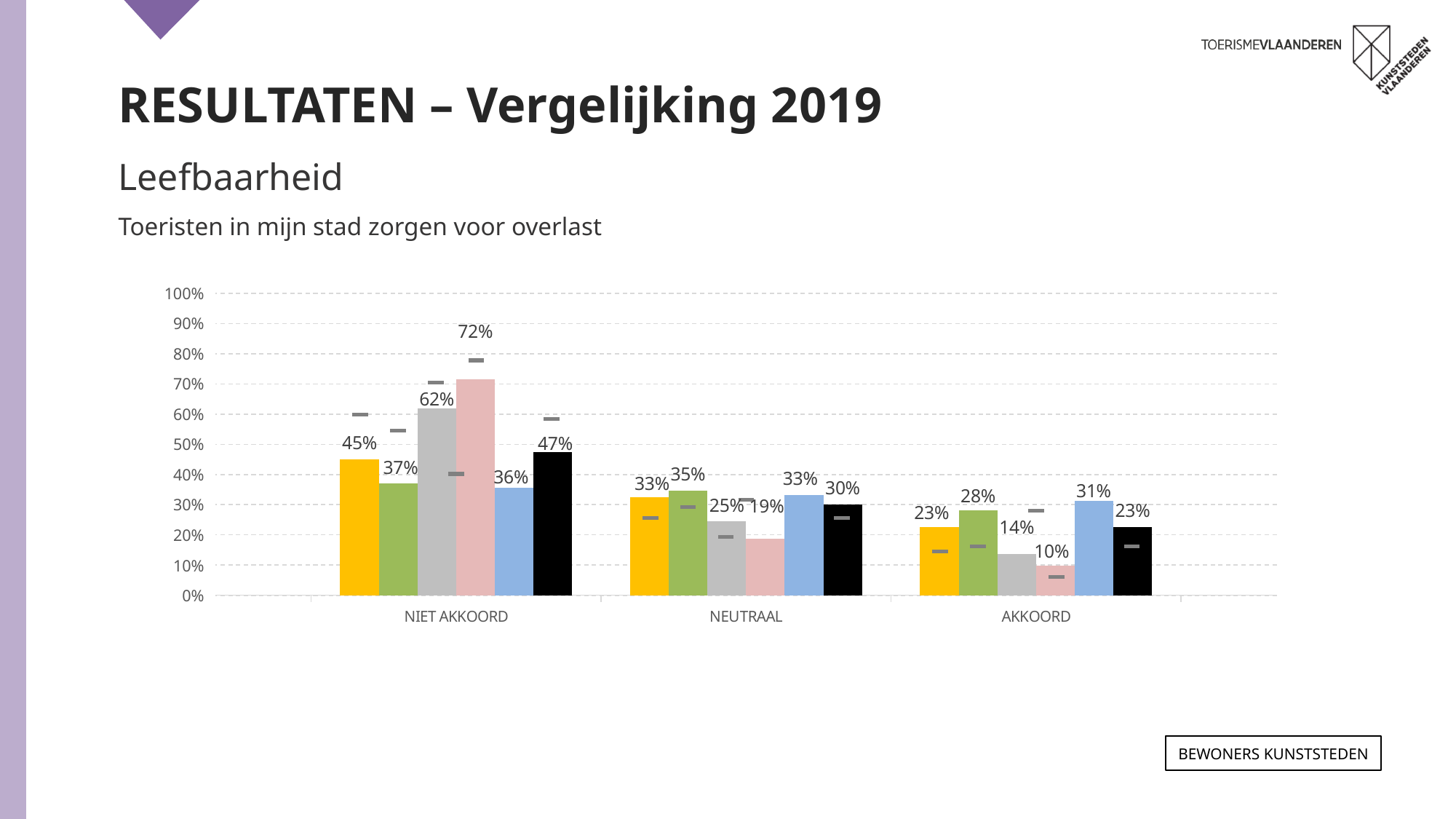
Which bar is the lowest in the AKKOORD category? the pink bar (10%) How many bars are shown in each category? 6 What is the value of the blue bar in the NEUTRAAL category? 33% How many categories are shown on the x axis of the chart? 3 What is the value of the yellow bar in the AKKOORD category? 23% What statement is the chart about, according to the text above it? Toeristen in mijn stad zorgen voor overlast What is the value of the pink bar in the NIET AKKOORD category? 72% Which bar is the highest in the NIET AKKOORD category? the pink bar (72%) Which is larger in the NEUTRAAL category: the green bar or the pink bar? the green bar What is the difference between the grey bar and the green bar in the NIET AKKOORD category? 25% Is the value of the black bar in the NIET AKKOORD category greater or less than 40%? greater What type of chart is shown on the slide? bar chart